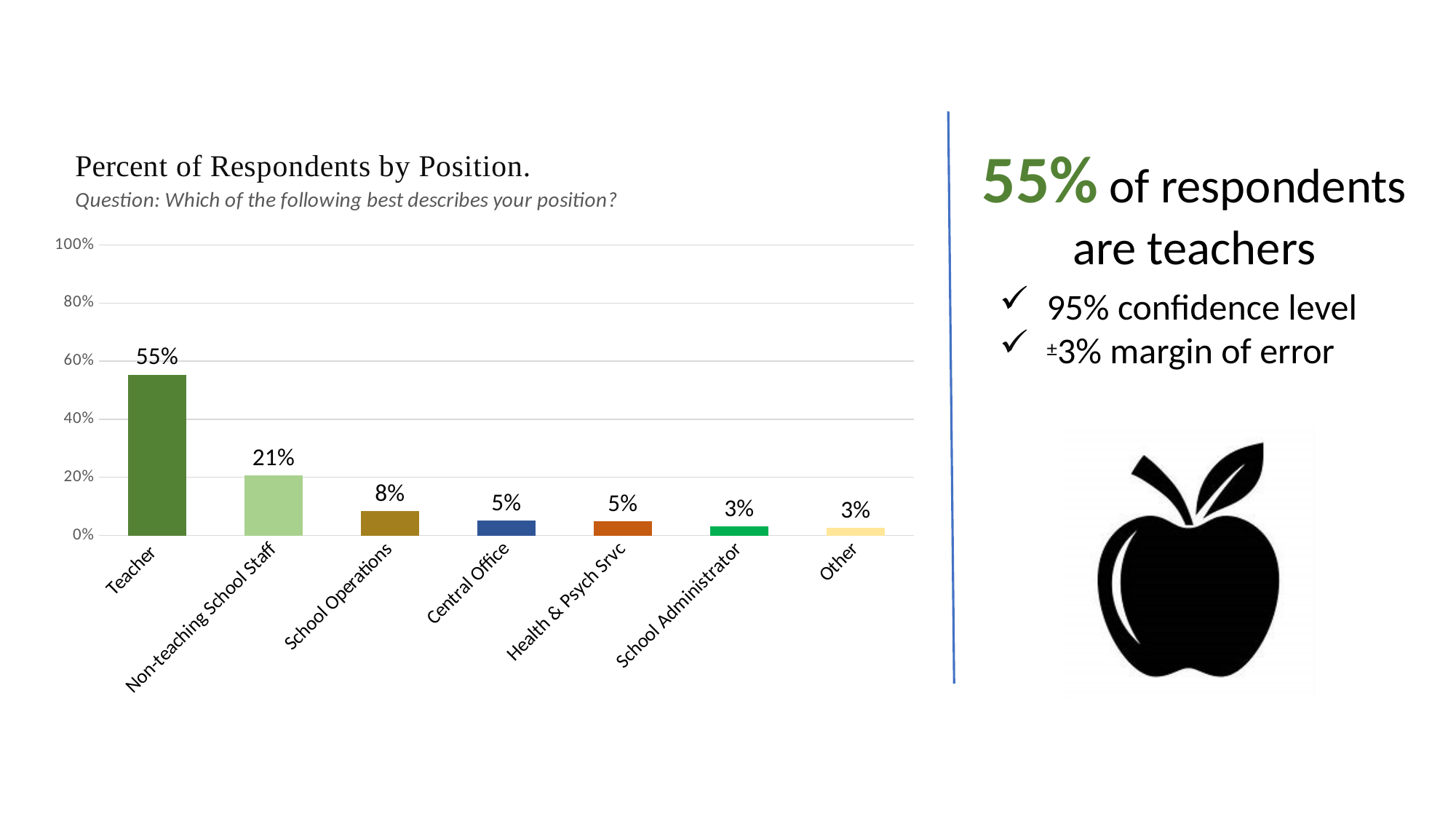
What is the title of the chart? Percent of Respondents by Position. What is the value for School Operations? 8% What is the difference between the School Operations and Central Office values? 3% Is the value for Teacher greater or less than 40%? greater What percentage of respondents are Teachers? 55% What is the value for School Administrator? 3% Which position has the highest percentage of respondents? Teacher What kind of chart is shown on the slide? Bar chart How many position categories are shown on the chart? 7 What is the difference between the Teacher and Non-teaching School Staff values? 34% Which is larger, the value for Non-teaching School Staff or the value for School Operations? Non-teaching School Staff What is the value for Non-teaching School Staff? 21%